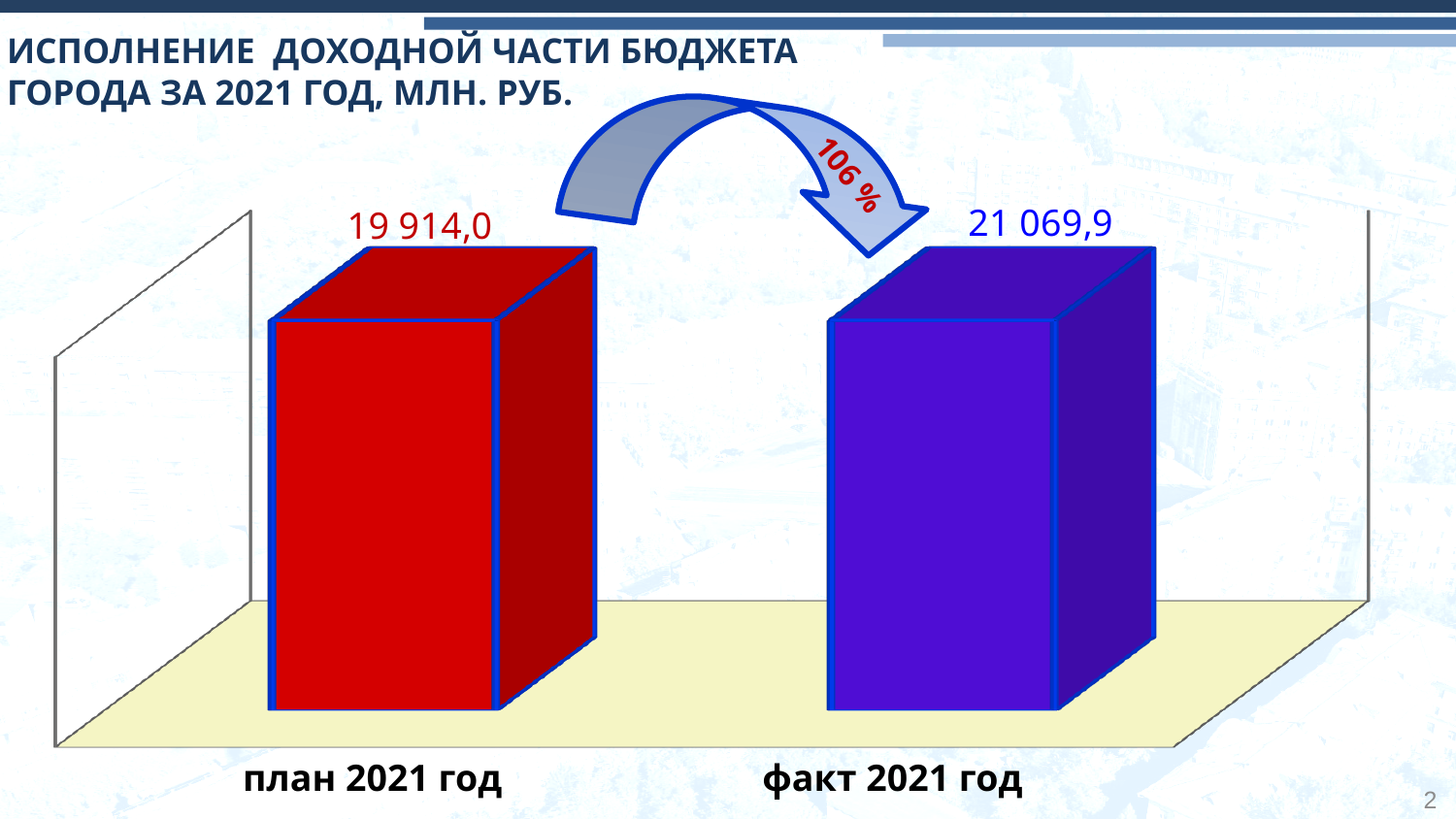
What is the value for план 2021 год? 19 914,0 Is the value for план 2021 год larger or smaller than the value for факт 2021 год? smaller What is the value for факт 2021 год? 21 069,9 What type of chart is shown on the slide? bar chart How many bars are shown in the chart? 2 Which category has the higher value, план 2021 год or факт 2021 год? факт 2021 год Do the values rise or fall from план 2021 год to факт 2021 год? rise In what units are the values on the chart given, according to the title? млн. руб. What colour is the bar for план 2021 год? red Which category has the lower value? план 2021 год What percentage is shown on the arrow between the two bars? 106 % What is the difference between факт 2021 год and план 2021 год? 1 155,9